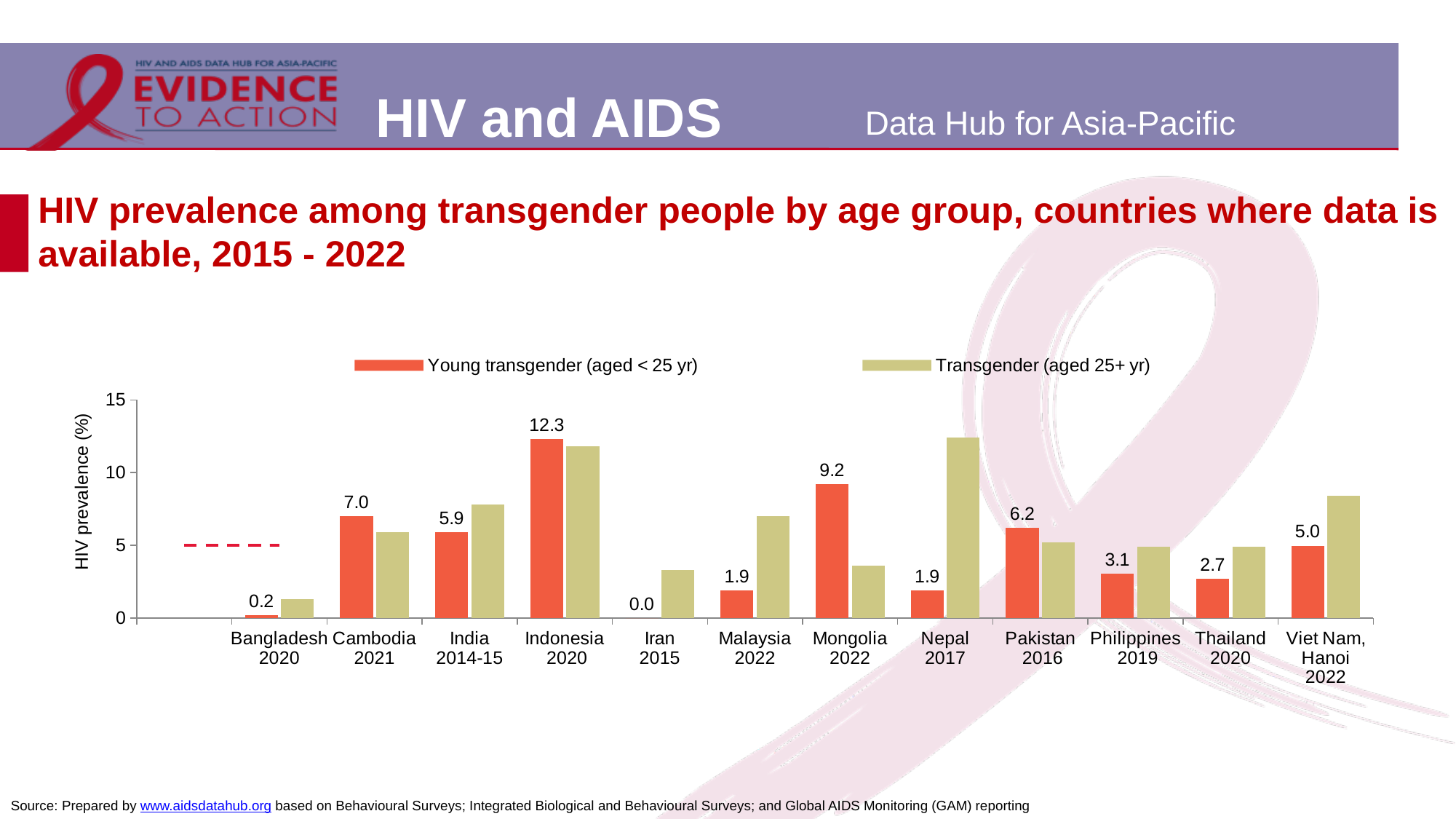
Is the HIV prevalence among transgender people aged 25+ yr in Iran 2015 greater or less than 5? less How many countries are shown on the x axis of the chart? 12 What is the HIV prevalence among young transgender people (aged < 25 yr) in Indonesia 2020? 12.3 What is the difference in HIV prevalence among young transgender people (aged < 25 yr) between Indonesia 2020 and Mongolia 2022? 3.1 Which has a higher HIV prevalence among young transgender people (aged < 25 yr): Cambodia 2021 or India 2014-15? Cambodia 2021 What is the HIV prevalence among young transgender people (aged < 25 yr) in Thailand 2020? 2.7 Is the HIV prevalence among transgender people aged 25+ yr in Nepal 2017 greater or less than 10? greater Which country has the highest HIV prevalence among young transgender people (aged < 25 yr)? Indonesia 2020 What kind of chart is shown on the slide? Bar chart What is the HIV prevalence among young transgender people (aged < 25 yr) in Pakistan 2016? 6.2 How many series does the chart legend list? 2 Which country has the lowest HIV prevalence among young transgender people (aged < 25 yr)? Iran 2015